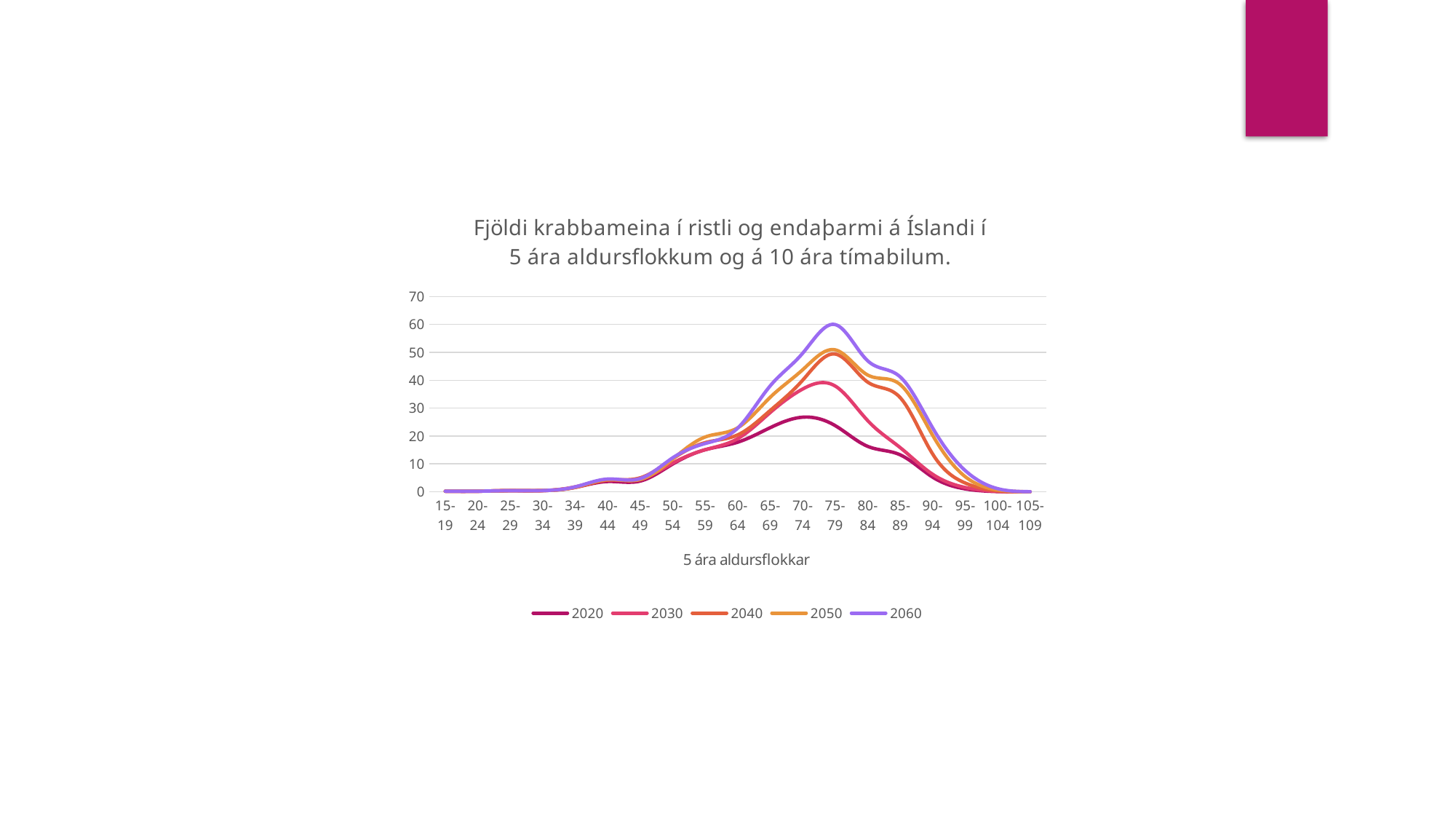
Which series is drawn in purple? 2060 Is the value for 2020 in the 75-79 age group greater or less than 30? less Do the values for the 2060 series rise or fall from the 75-79 age group to the 105-109 age group? fall How many series does the legend list? 5 What is the label of the x axis? 5 ára aldursflokkar Is the value for 2030 in the 75-79 age group greater or less than 30? greater In which age group does the 2060 series reach its peak? 75-79 How many age groups are shown along the x axis? 19 What kind of chart is shown on the slide? line chart Is the value for 2060 in the 75-79 age group greater or less than 50? greater Which series has the larger value in the 75-79 age group, 2020 or 2060? 2060 Which series reaches the highest value on the chart? 2060